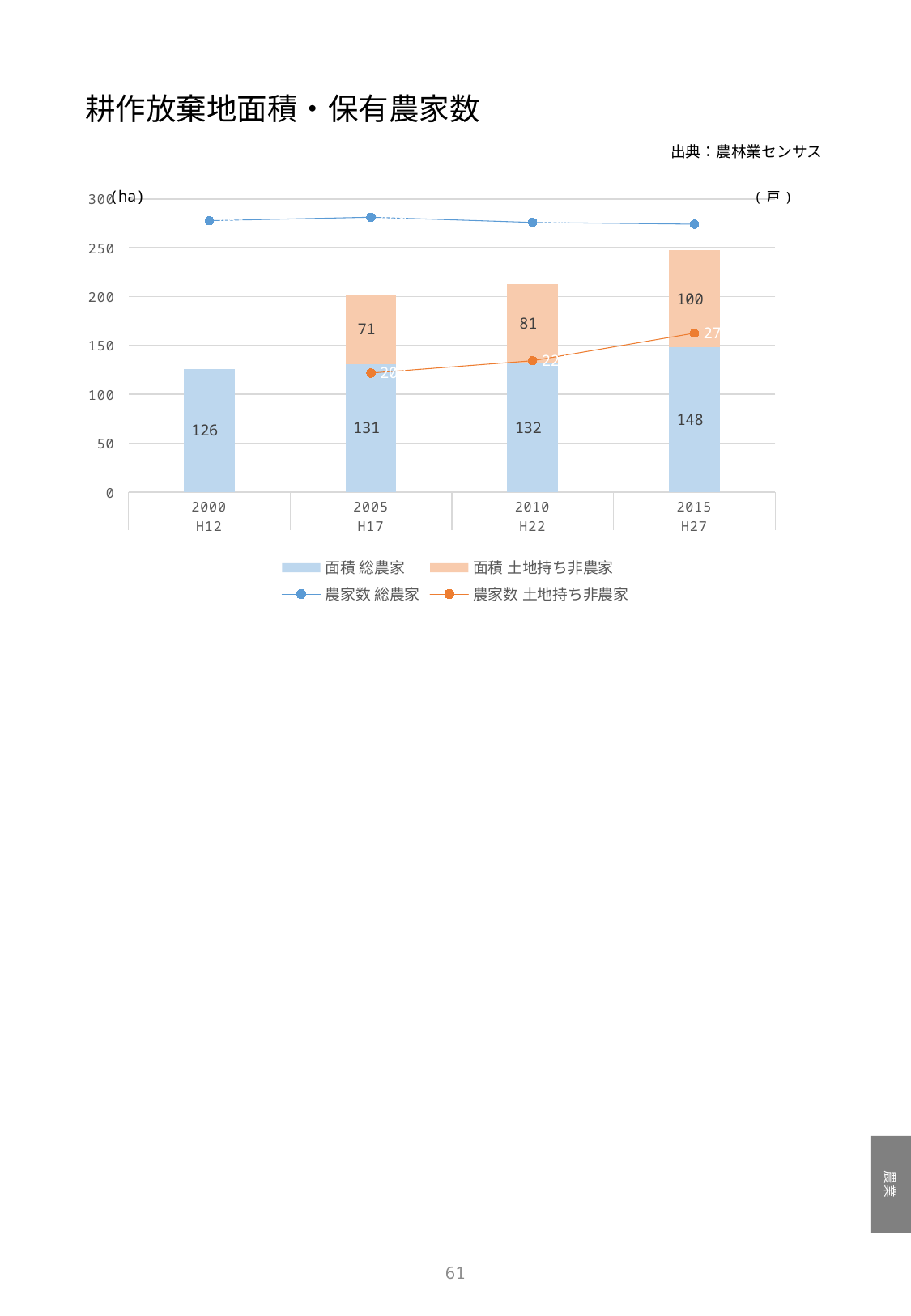
What is the difference between 面積 土地持ち非農家 in 2015 and in 2005? 29 What is the value of 面積 土地持ち非農家 for 2005 (H17)? 71 In which year is 面積 総農家 the lowest? 2000 (H12) What is the total height of the stacked bar for 2015 (H27)? 248 What is the total height of the stacked bar for 2010 (H22)? 213 In which year is 面積 総農家 the highest? 2015 (H27) How many series does the legend list? 4 Does 農家数 土地持ち非農家 rise or fall from 2005 to 2015? rise Which year has the larger 面積 総農家 value, 2005 or 2010? 2010 What is the value of 面積 総農家 for 2015 (H27)? 148 How many years are shown on the x axis? 4